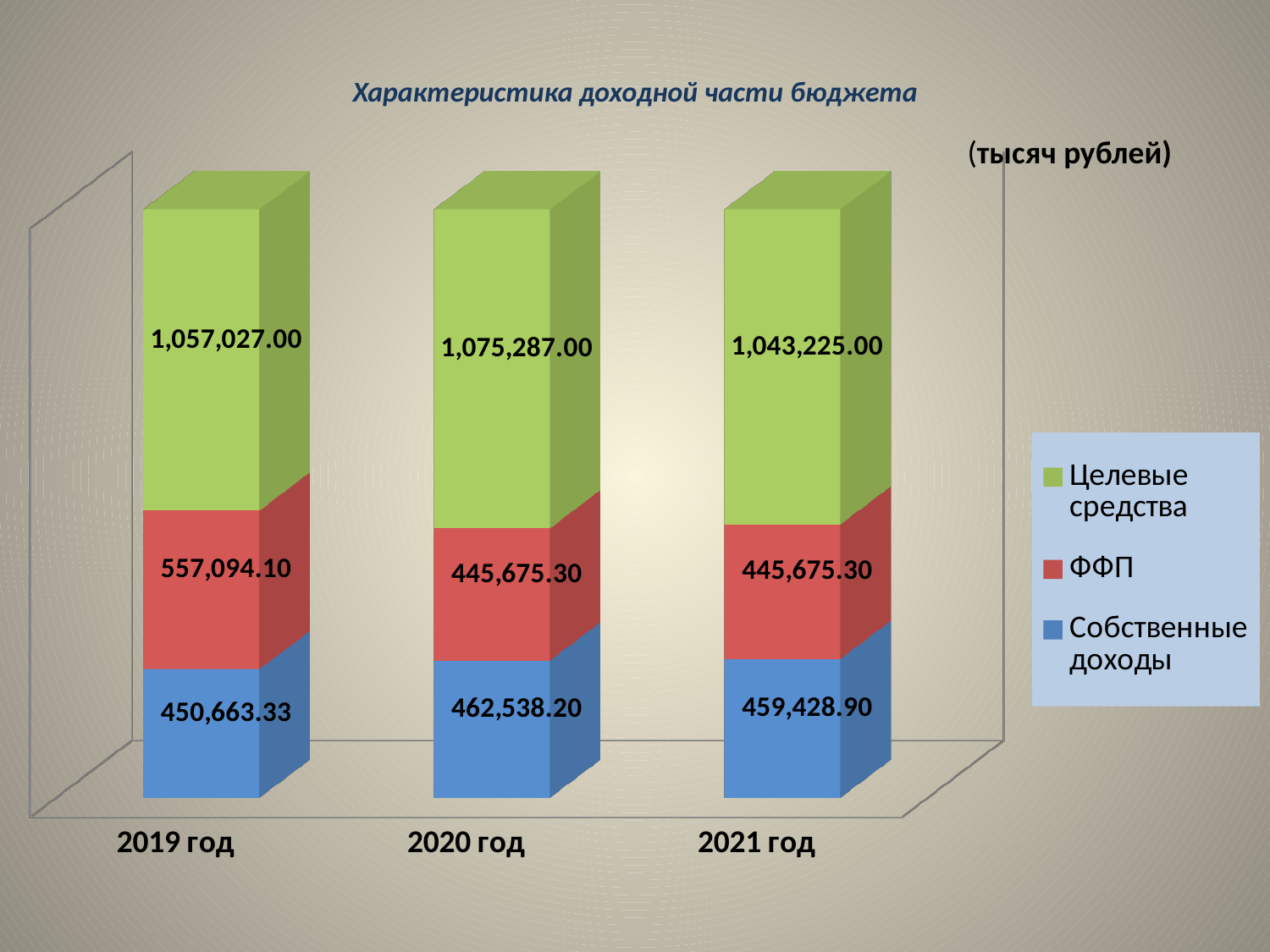
How many years are shown on the x axis? 3 What type of chart is shown on the slide? Stacked bar chart What is the title of the chart? Характеристика доходной части бюджета Which is larger: Целевые средства in 2019 год or Целевые средства in 2021 год? 2019 год What is the value of Целевые средства for 2020 год? 1,075,287.00 What is the value of Собственные доходы for 2021 год? 459,428.90 What is the difference between ФФП in 2019 год and ФФП in 2020 год? 111,418.80 What is the value of ФФП for 2019 год? 557,094.10 What is the total of the stacked bar for 2021 год? 1,948,329.20 In which year is Собственные доходы the lowest? 2019 год How many series does the legend list? 3 In which year is Целевые средства the highest? 2020 год